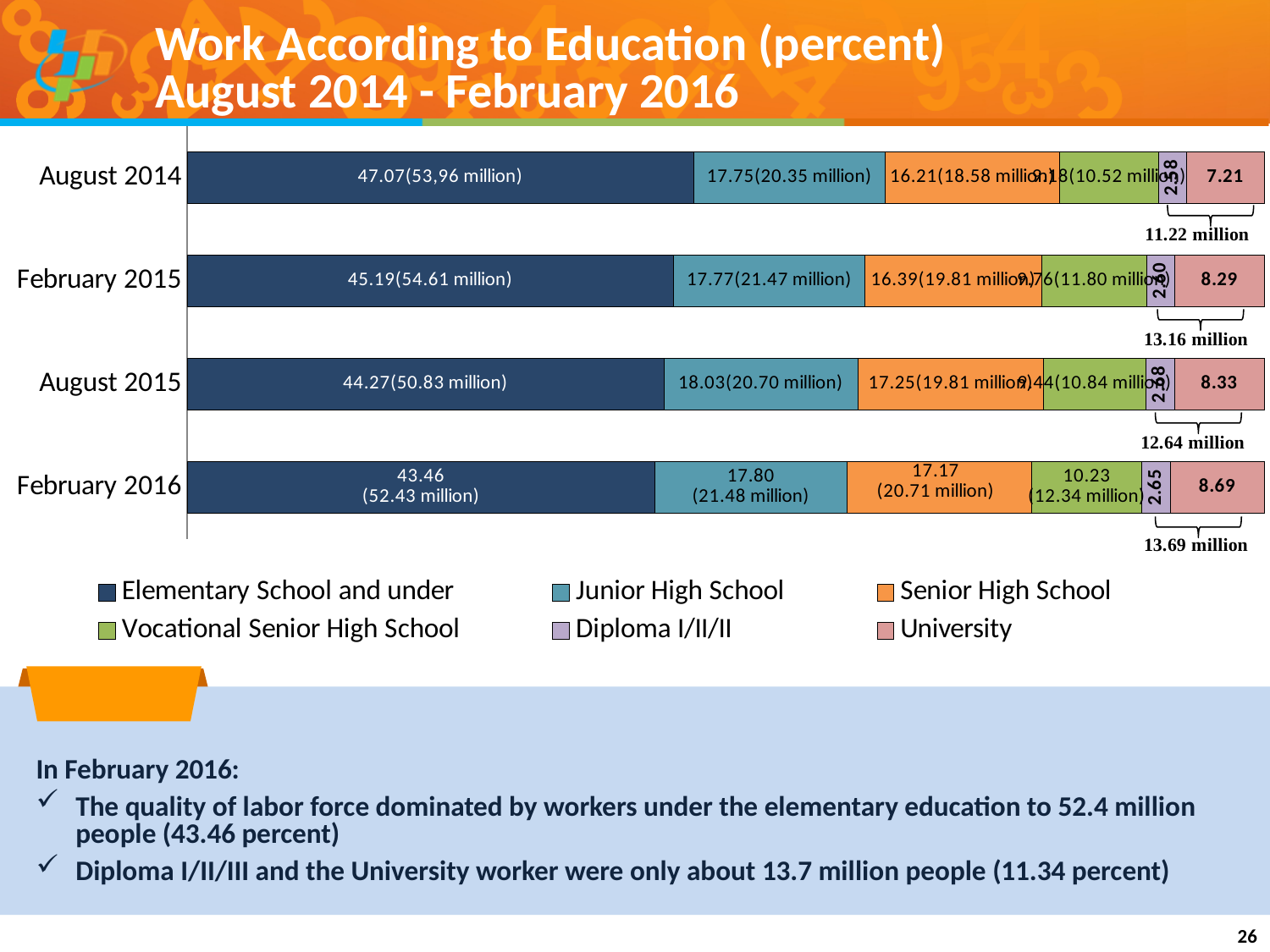
How many series does the legend list? 6 What is the percentage for Elementary School and under in February 2016? 43.46 What kind of chart is shown on the slide? Stacked bar chart What is the percentage for University in February 2016? 8.69 What is the percentage for Junior High School in August 2015? 18.03 In August 2014, which is larger: Junior High School or Senior High School? Junior High School What combined figure is shown beside the bracket for Diploma and University in February 2016? 13.69 million In which period is the University percentage highest? February 2016 Does the share of Elementary School and under rise or fall from August 2014 to February 2016? Fall How many time periods are plotted on the chart? 4 What is the difference between the Elementary School and under percentage in August 2014 and in February 2016? 3.61 What is the percentage for Senior High School in February 2015? 16.39